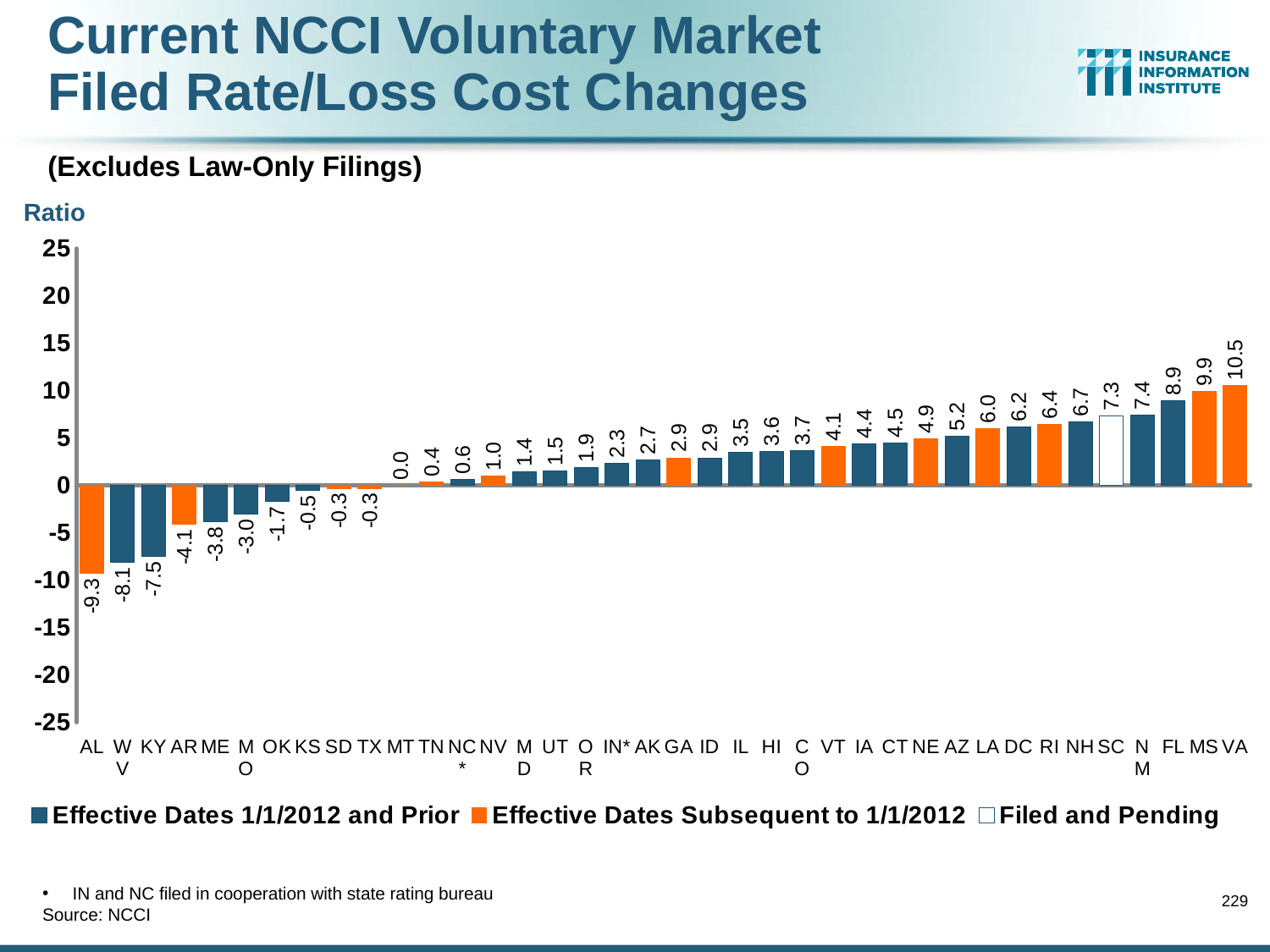
What kind of chart is this? bar chart How many states are shown on the x axis? 38 What is the value for VA? 10.5 How many series does the legend list? 3 What is the value for SC? 7.3 Which is larger, the value for FL or the value for NH? FL Which state has the highest value? VA Which legend entry is shown with an unfilled (white) bar? Filed and Pending Which state has the lowest value? AL What is the difference between the values for VA and MS? 0.6 Is the value for KY greater or less than -5? less What is the value for AL? -9.3